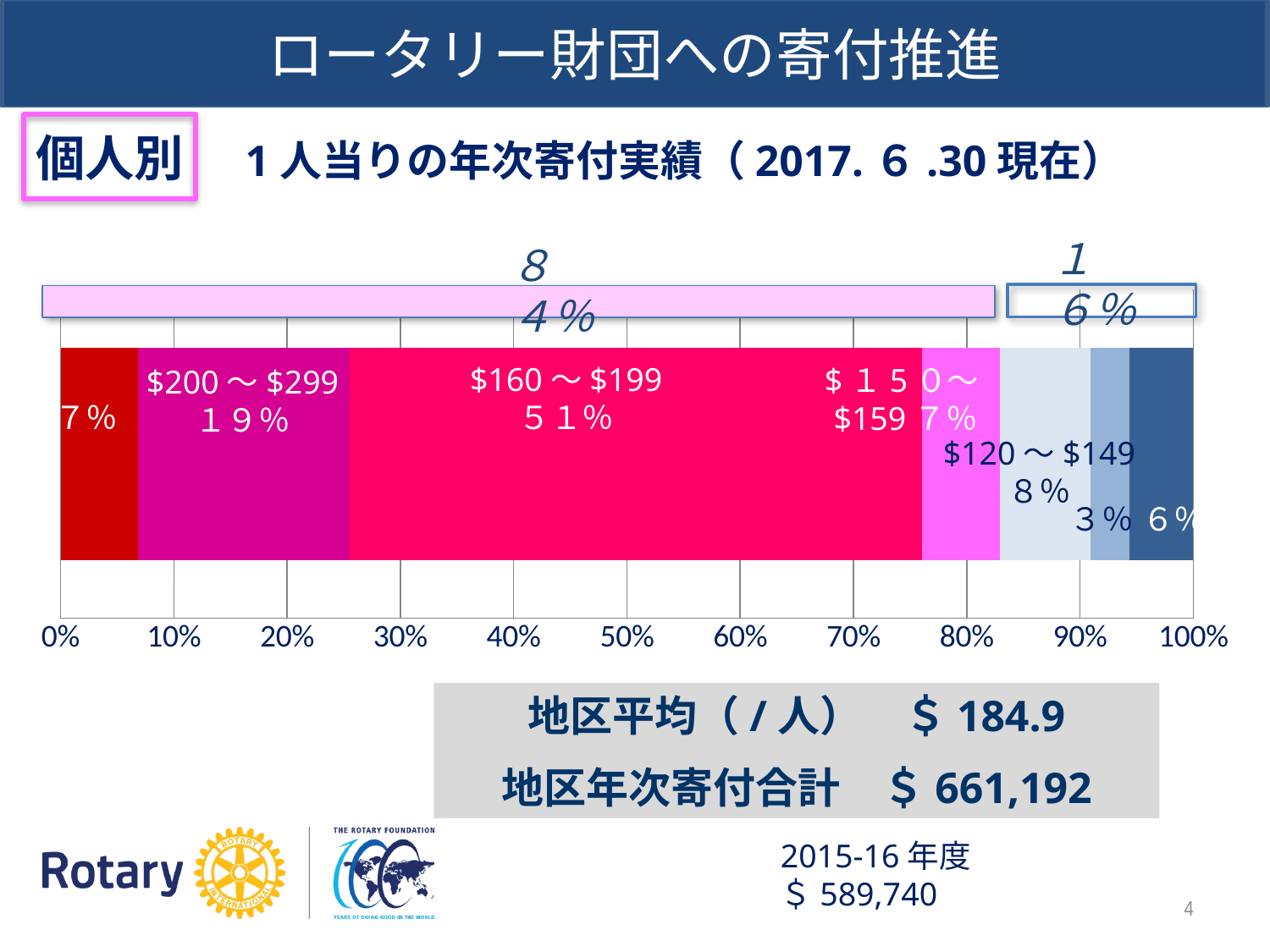
What percentage is shown for the rightmost dark blue segment of the bar? 6% Which contribution range has the largest share of the bar? $160～$199 What percentage is shown for the $150～$159 segment? 7% Which segment is larger, $200～$299 or $120～$149? $200～$299 How many segments make up the stacked bar? 7 What percentage of members gave $160～$199 per person? 51% What percentage is shown for the $200～$299 segment? 19% What kind of chart is shown on the slide? Stacked bar chart What percentage does the pink bracket above the bar indicate? 84% What is the difference in percentage points between the $160～$199 segment and the $200～$299 segment? 32% What percentage is shown for the $120～$149 segment? 8% What percentage does the blue-outlined bracket above the right end of the bar indicate? 16%